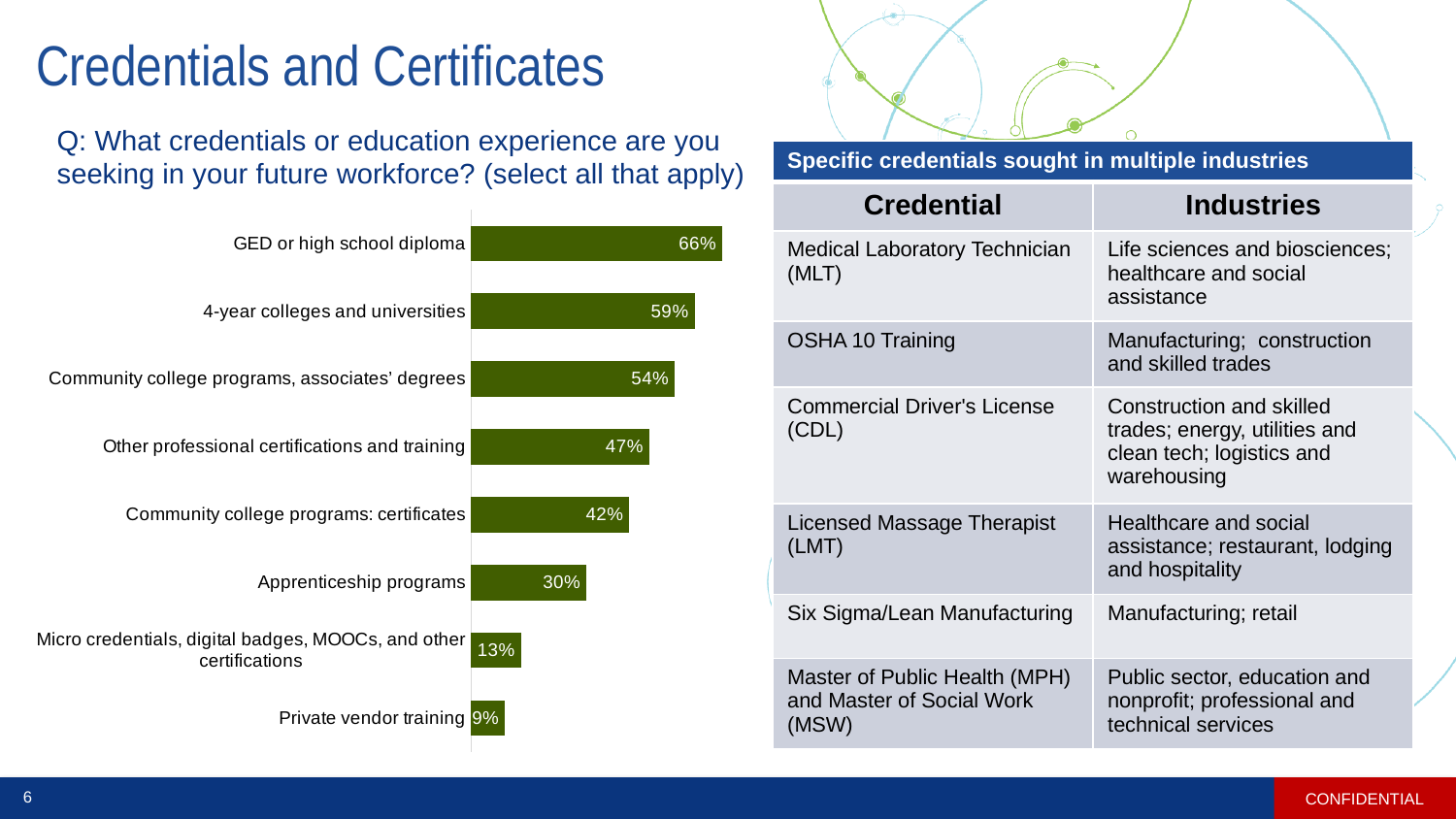
What is the difference between the values for Other professional certifications and training and Private vendor training? 38% Which is larger: the value for Community college programs, associates' degrees or the value for Community college programs: certificates? Community college programs, associates' degrees What is the value shown for Apprenticeship programs? 30% What is the value shown for Community college programs: certificates? 42% Which category has the lowest value in the chart? Private vendor training How many categories are shown in the bar chart? 8 Which category has the highest value in the chart? GED or high school diploma What colour are the bars in the chart? Dark green What is the difference between the values for 4-year colleges and universities and Apprenticeship programs? 29% What is the value shown for Micro credentials, digital badges, MOOCs, and other certifications? 13% What percentage of respondents are seeking GED or high school diploma credentials? 66% What kind of chart is shown on the slide? Bar chart